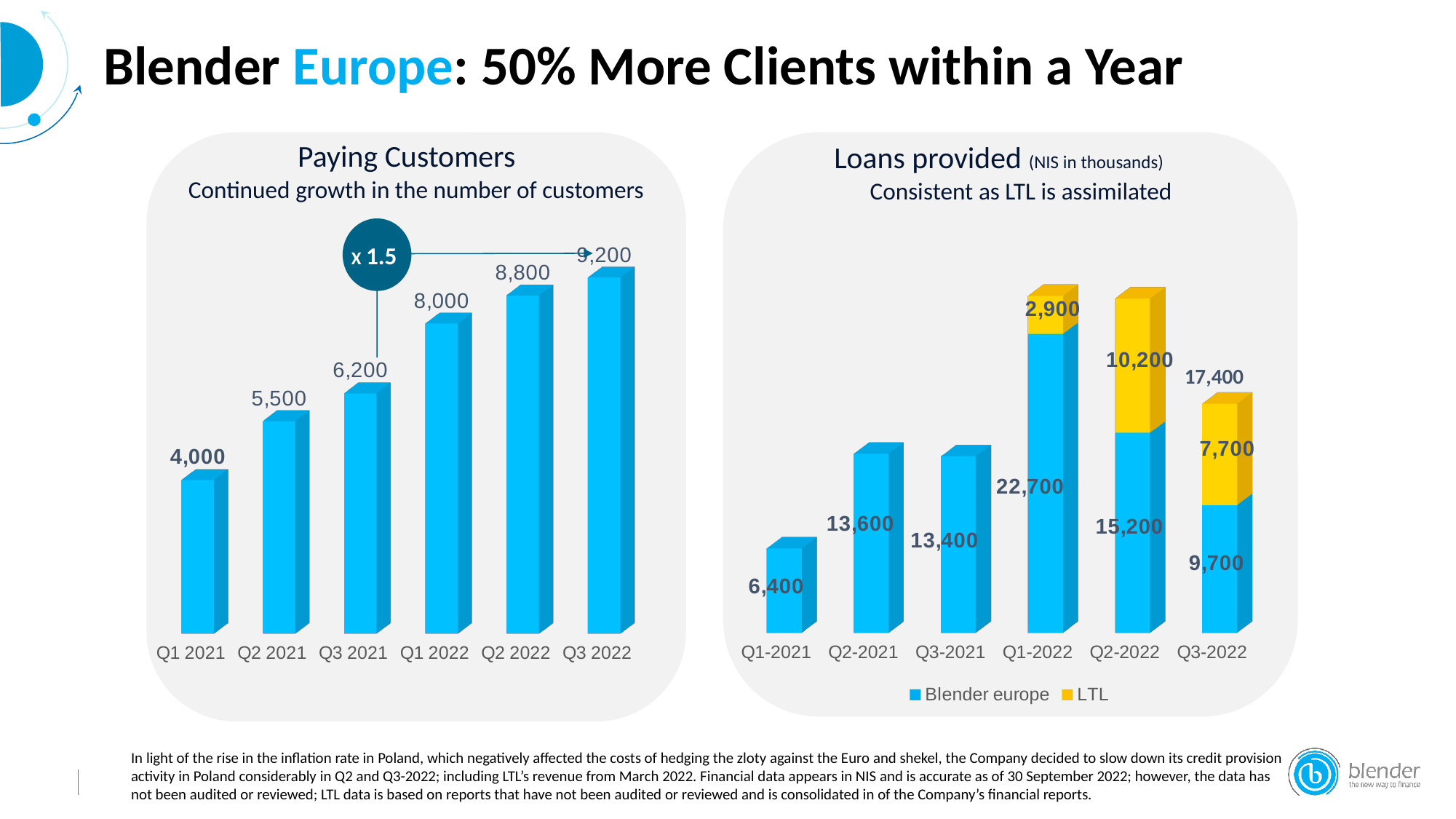
In the Loans provided chart, which is larger for Q2-2022: Blender europe or LTL? Blender europe In the Paying Customers chart, how many quarters are shown? 6 What kind of chart is the Loans provided chart? stacked bar chart In the Paying Customers chart, do the values rise or fall from Q1 2021 to Q3 2022? rise In the Paying Customers chart, what is the difference between Q3 2022 and Q3 2021? 3,000 In the Paying Customers chart, what is the value for Q3 2022? 9,200 In the Loans provided chart, how many series does the legend list? 2 In the Loans provided chart, what is the LTL value for Q2-2022? 10,200 In the Loans provided chart, what is the total of the stacked bar for Q3-2022? 17,400 In the Paying Customers chart, which quarter has the lowest value? Q1 2021 In the Loans provided chart, what is the Blender europe value for Q1-2022? 22,700 In the Paying Customers chart, what is the value for Q1 2021? 4,000